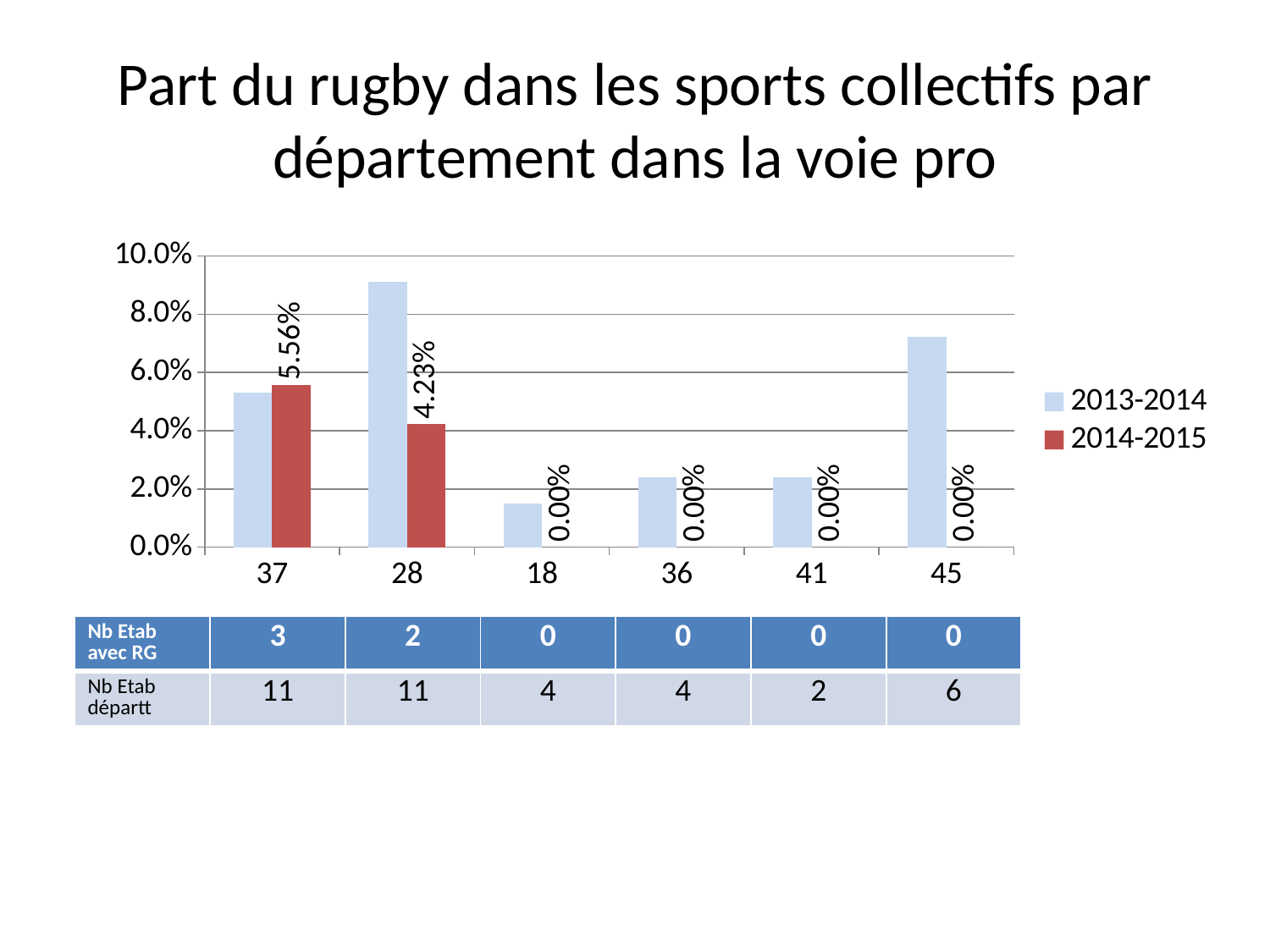
Is the 2013-2014 value for department 18 greater or less than 2.0%? less For 2013-2014, which department has the larger value, 28 or 45? 28 What is the 2014-2015 value for department 37? 5.56% How many departments are shown on the x axis of the chart? 6 What is the difference between the 2014-2015 values for departments 37 and 28? 1.33% Which department has the highest 2013-2014 value? 28 Which department has the highest 2014-2015 value? 37 What is the 2014-2015 value for department 28? 4.23% What is the 2014-2015 value for department 18? 0.00% Is the 2013-2014 value for department 28 greater or less than 8.0%? greater Which department has the lowest 2013-2014 value? 18 How many series does the chart legend list? 2